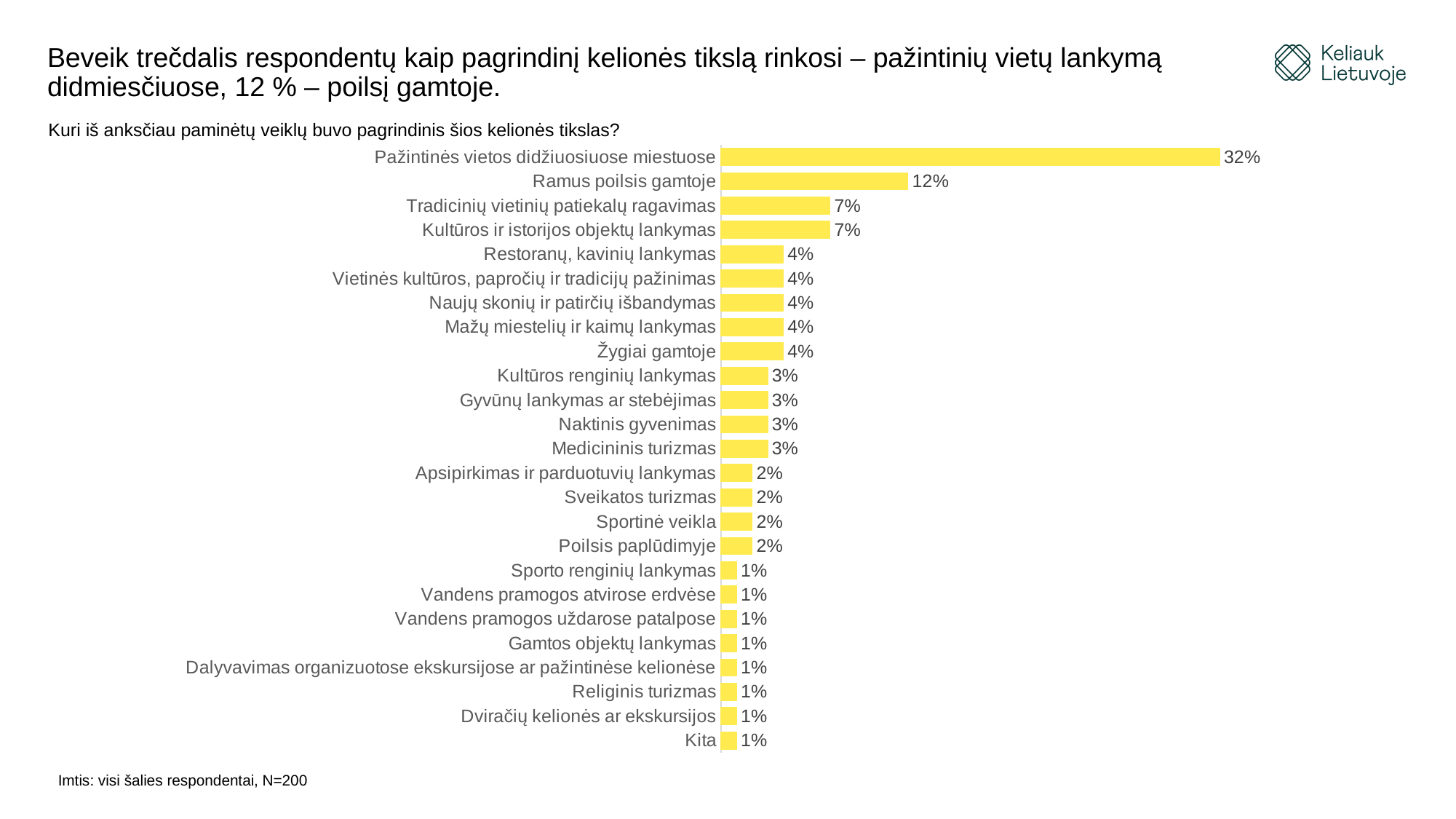
What is the sample size stated below the chart? N=200 Which is larger: the value for "Kultūros ir istorijos objektų lankymas" or the value for "Restoranų, kavinių lankymas"? Kultūros ir istorijos objektų lankymas What is the value shown for "Ramus poilsis gamtoje"? 12% What type of chart is shown on the slide? Bar chart How many categories are shown in the chart? 25 What is the value shown for "Medicininis turizmas"? 3% What percentage of respondents chose "Pažintinės vietos didžiuosiuose miestuose" as the main purpose of the trip? 32% What is the difference between the values for "Pažintinės vietos didžiuosiuose miestuose" and "Ramus poilsis gamtoje"? 20% Which category has the highest value in the chart? Pažintinės vietos didžiuosiuose miestuose Which is larger: the value for "Sveikatos turizmas" or the value for "Naktinis gyvenimas"? Naktinis gyvenimas What is the value shown for "Poilsis paplūdimyje"? 2% What is the difference between the values for "Tradicinių vietinių patiekalų ragavimas" and "Žygiai gamtoje"? 3%